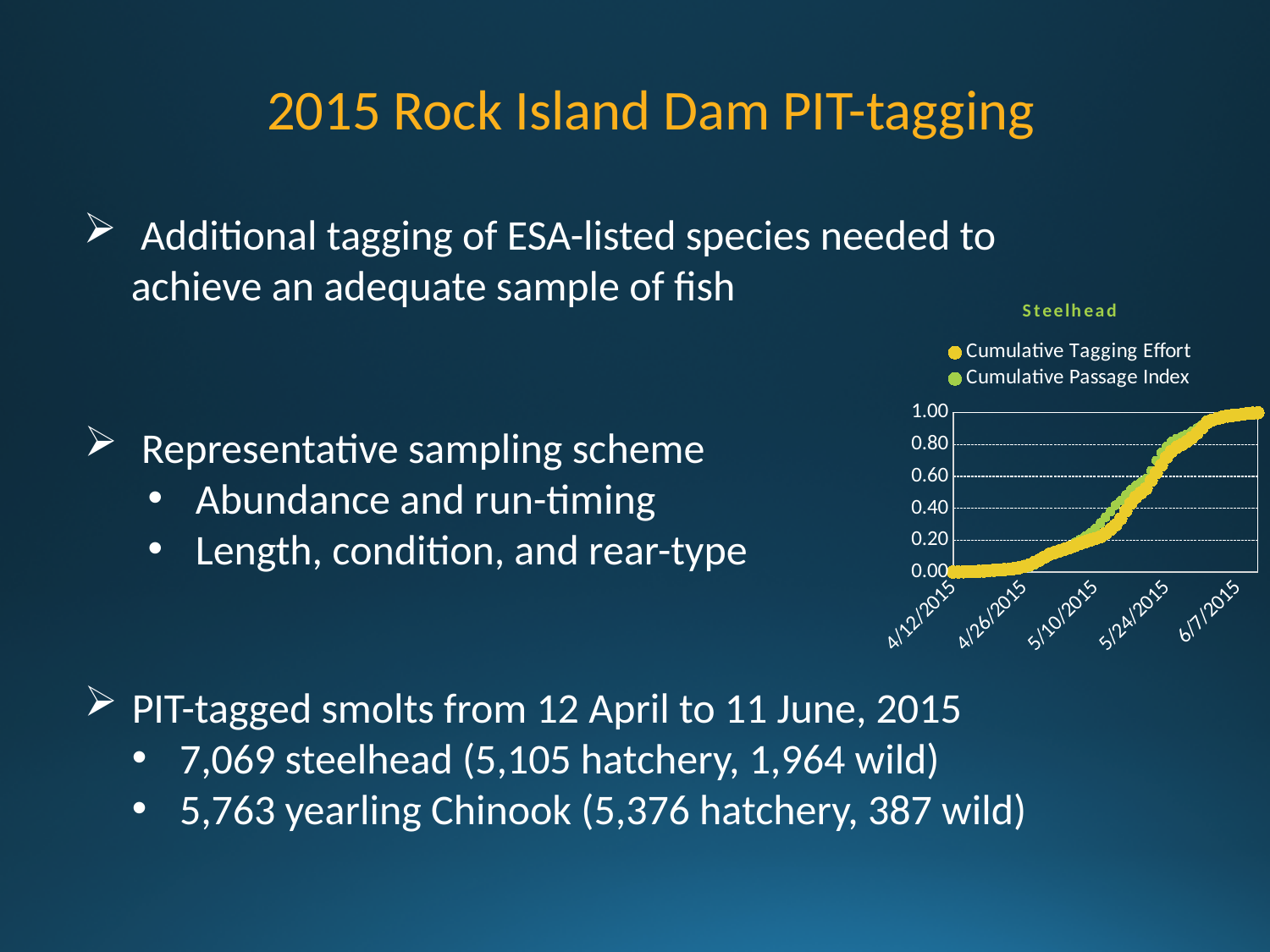
What kind of chart is shown on the slide? Scatter chart How many series does the chart legend list? 2 What is the highest value shown on the chart's y axis? 1.00 Is the Cumulative Tagging Effort value at 5/24/2015 greater or less than 0.40? greater Is the Cumulative Passage Index value at 6/7/2015 greater or less than 0.80? greater Is the Cumulative Passage Index value at 5/10/2015 greater or less than 0.60? less What is the title of the chart on the slide? Steelhead Do the plotted values rise or fall as the dates move from 4/12/2015 to 6/7/2015? Rise What are the two series named in the chart legend? Cumulative Tagging Effort and Cumulative Passage Index How many date labels are shown along the chart's x axis? 5